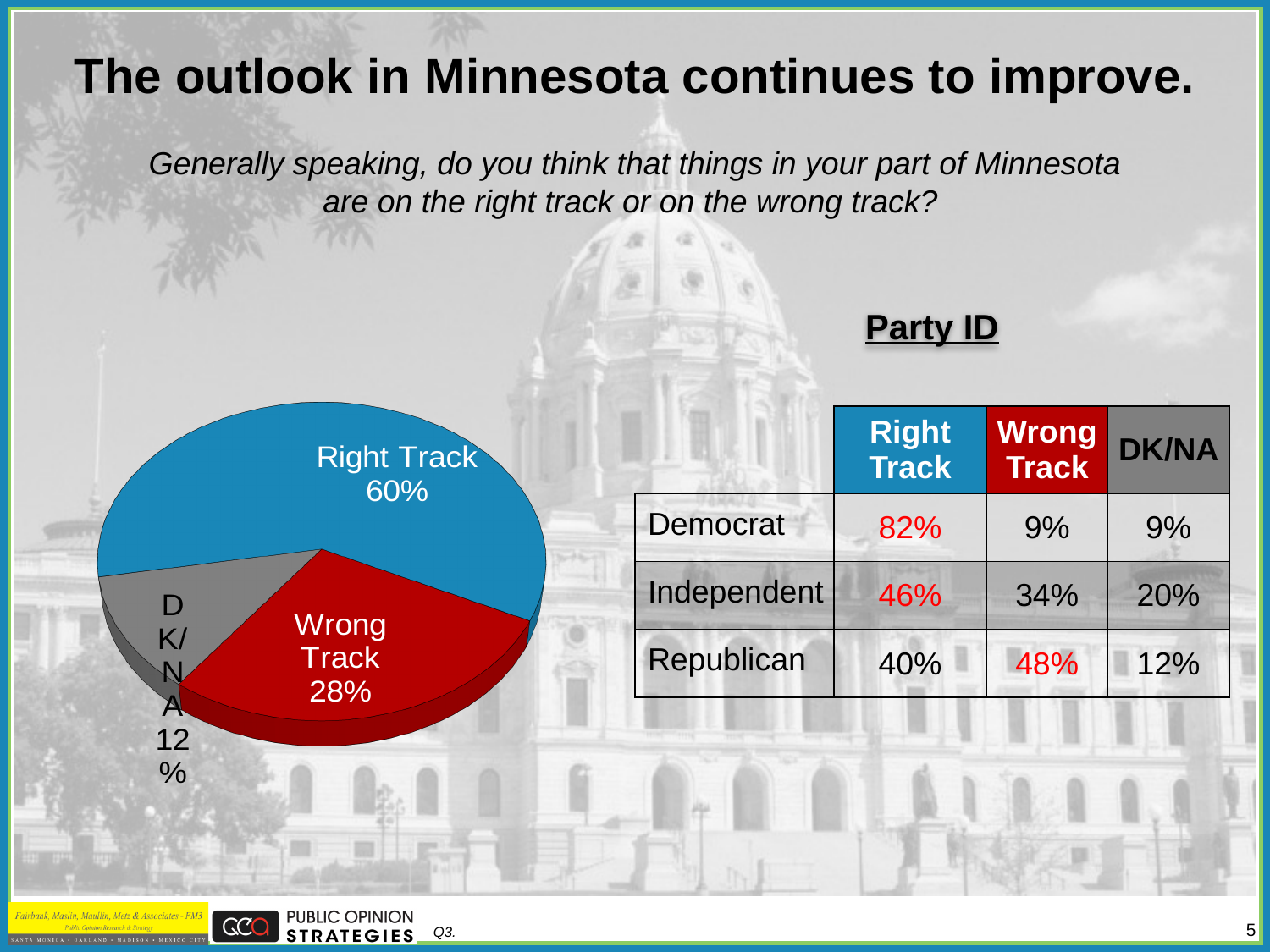
What is the combined share of Wrong Track and DK/NA in the pie chart? 40% Which slice of the pie chart is the smallest? DK/NA What percentage of the pie chart is DK/NA? 12% How many slices does the pie chart have? 3 Which slice of the pie chart is the largest? Right Track What percentage of the pie chart is Wrong Track? 28% What colour is the Wrong Track slice in the pie chart? red What colour is the Right Track slice in the pie chart? blue What percentage of the pie chart is Right Track? 60% Which is larger in the pie chart, Wrong Track or DK/NA? Wrong Track What kind of chart is shown on the slide? pie chart What is the difference between the Right Track and Wrong Track shares in the pie chart? 32%